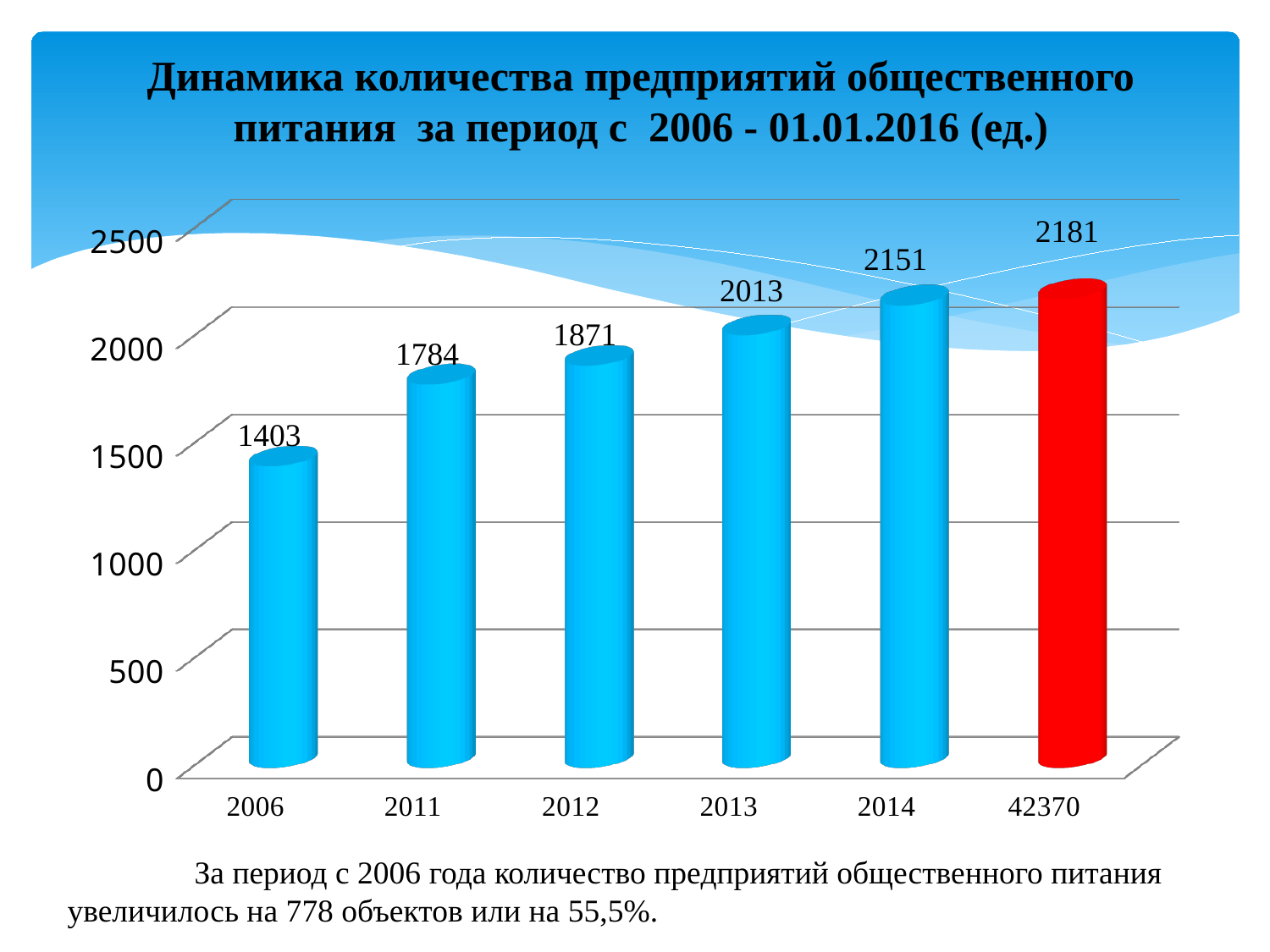
Which is larger, the value for 2013 or the value for 2011? 2013 What is the difference between the values for 2012 and 2011? 87 What is the value for 2006? 1403 Which category has the lowest value? 2006 What is the value for 2013? 2013 What is the value for 2014? 2151 What is the value for the category labelled 42370? 2181 Which category has the highest value? 42370 What is the difference between the values for 2014 and 2006? 748 How many categories are shown on the x axis? 6 What kind of chart is this? bar chart Do the values rise or fall from left to right along the x axis? rise